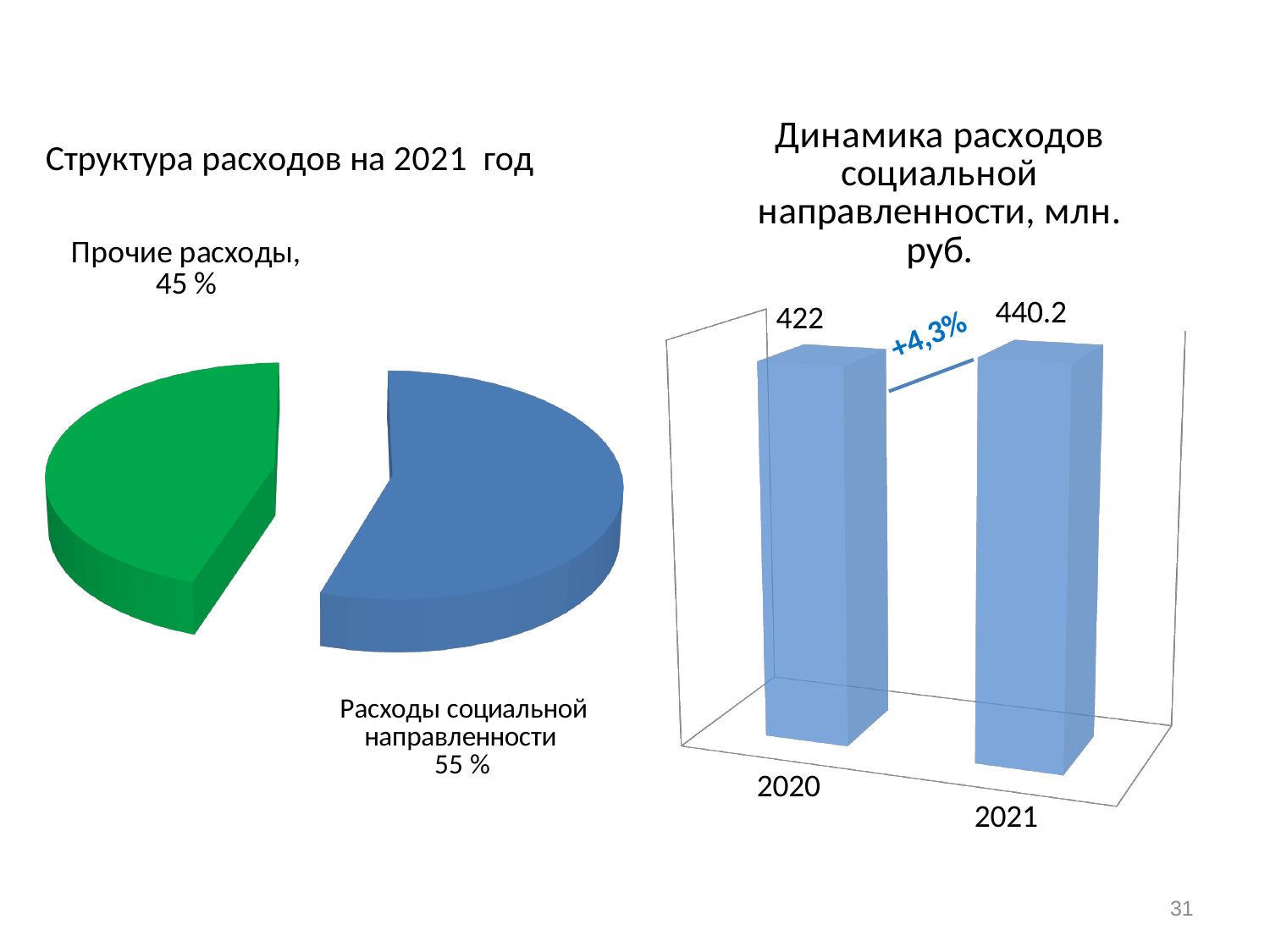
In the chart 'Структура расходов на 2021 год', what share of expenses is 'Прочие расходы'? 45 % In the chart 'Структура расходов на 2021 год', which slice is larger: 'Прочие расходы' or 'Расходы социальной направленности'? Расходы социальной направленности What kind of chart is 'Структура расходов на 2021 год'? Pie chart In the chart 'Динамика расходов социальной направленности, млн. руб.', by how much does the 2021 value exceed the 2020 value? 18.2 In the chart 'Динамика расходов социальной направленности, млн. руб.', what is the value for 2021? 440.2 What kind of chart is 'Динамика расходов социальной направленности, млн. руб.'? Bar chart In the chart 'Динамика расходов социальной направленности, млн. руб.', what is the value for 2020? 422 How many slices does the pie chart 'Структура расходов на 2021 год' have? 2 In the chart 'Динамика расходов социальной направленности, млн. руб.', do the values rise or fall from 2020 to 2021? Rise In the chart 'Структура расходов на 2021 год', what share of expenses is 'Расходы социальной направленности'? 55 % In the chart 'Динамика расходов социальной направленности, млн. руб.', which year has the higher value? 2021 In the chart 'Динамика расходов социальной направленности, млн. руб.', what percentage change is annotated between the two bars? +4,3%